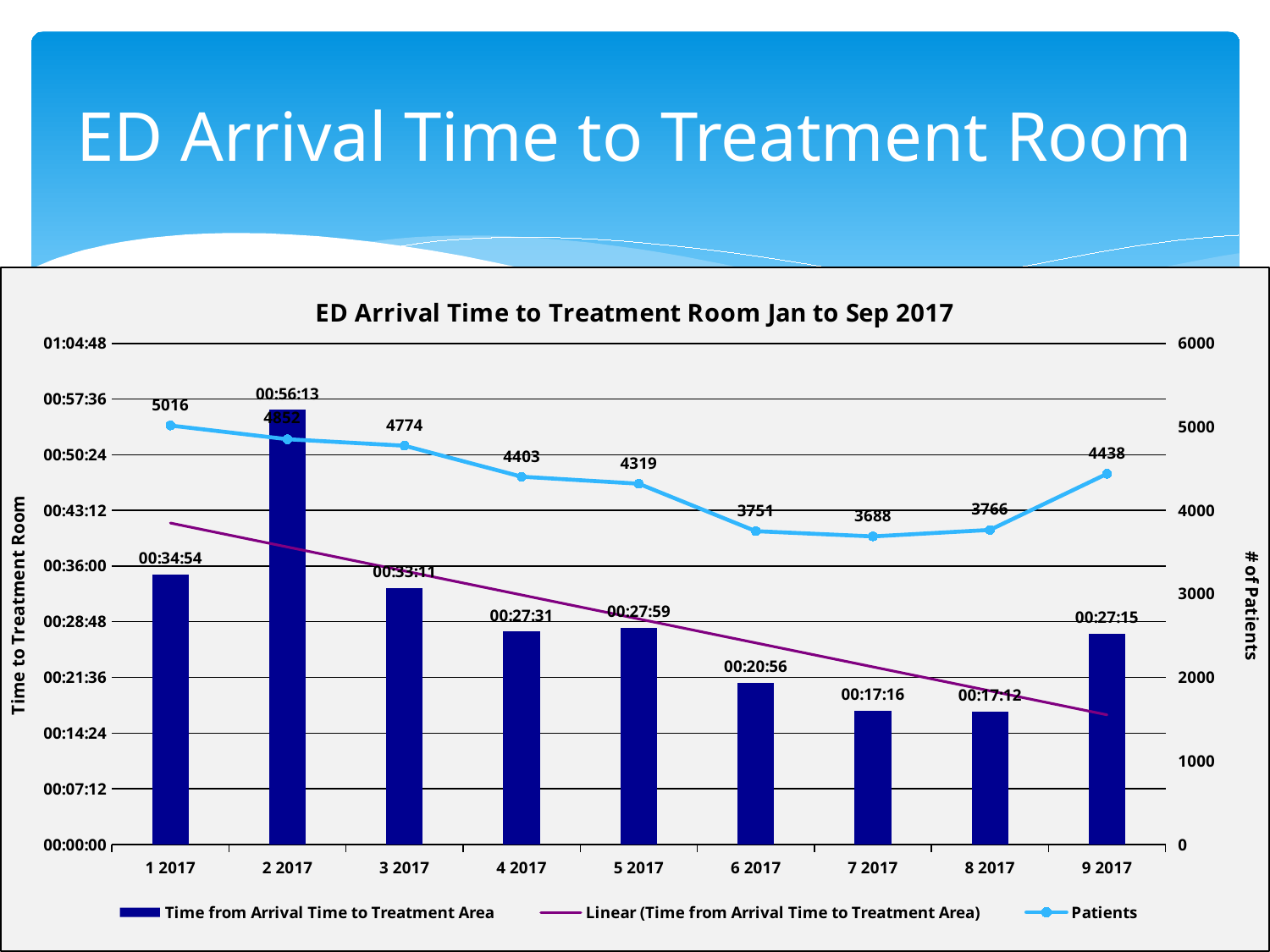
How many series does the legend list? 3 How many months are shown on the x axis? 9 Which month has the highest number of Patients? 1 2017 How many Patients are shown for 6 2017? 3751 What is the difference in Patients between 1 2017 and 9 2017? 578 Which month has the lowest number of Patients? 7 2017 What is the Time from Arrival Time to Treatment Area for 9 2017? 00:27:15 What is the Time from Arrival Time to Treatment Area for 2 2017? 00:56:13 Which month has the highest Time from Arrival Time to Treatment Area? 2 2017 Is the number of Patients for 5 2017 greater or less than 4000? greater Which has more Patients, 4 2017 or 8 2017? 4 2017 What kind of chart is this? Combined bar and line chart